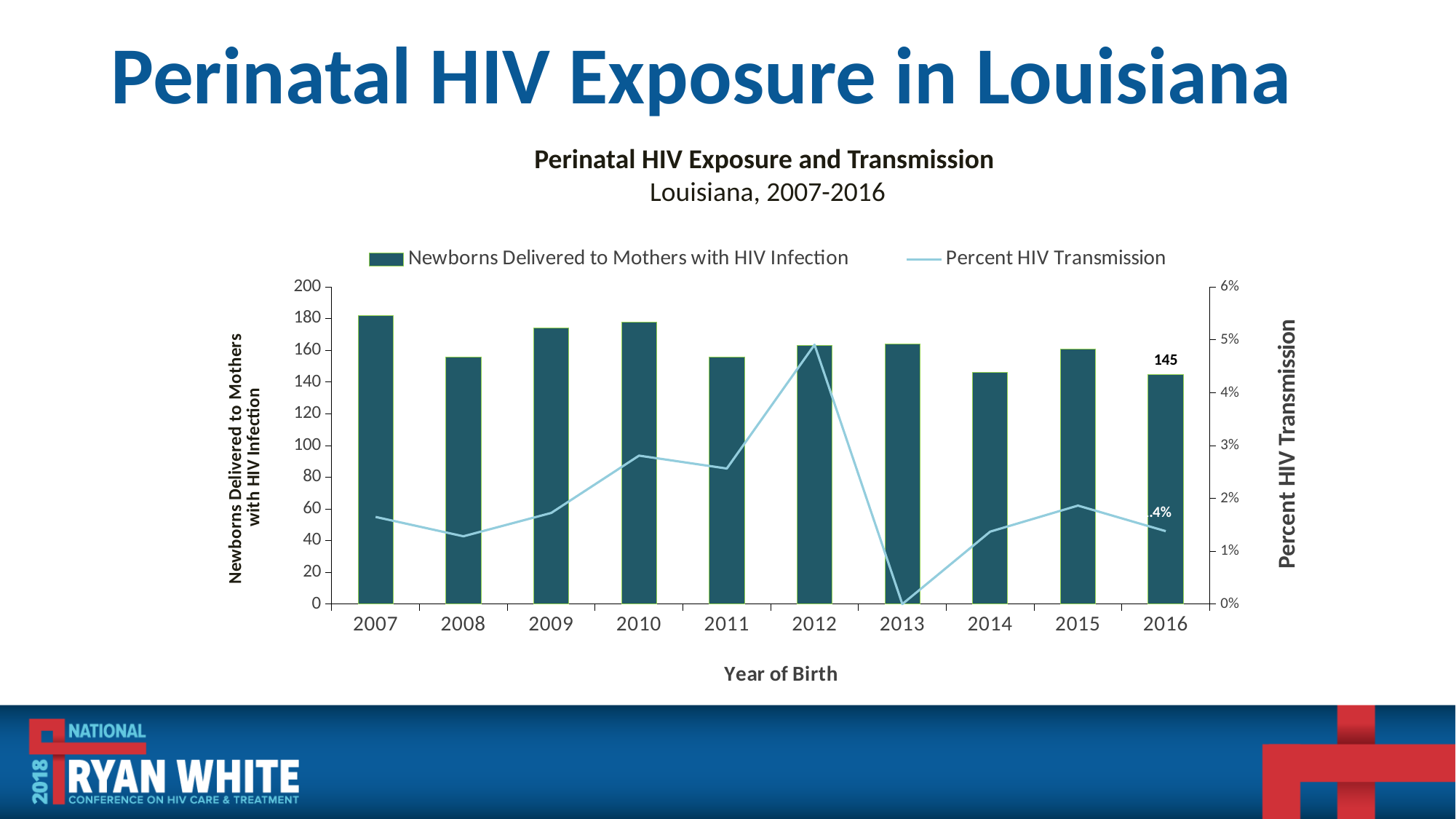
How many series does the legend list? 2 In which year of birth is the percent HIV transmission lowest? 2013 What kind of chart is shown on the slide? A combination bar and line chart Is the percent HIV transmission in 2012 greater or less than 4%? greater What is the percent HIV transmission in 2013? 0% Which year had more newborns delivered to mothers with HIV infection, 2007 or 2008? 2007 Is the number of newborns delivered to mothers with HIV infection in 2014 greater or less than 160? less Is the number of newborns delivered to mothers with HIV infection in 2007 greater or less than 160? greater What is the number of newborns delivered to mothers with HIV infection in 2016? 145 How many years of birth are shown on the x axis? 10 In which year of birth is the percent HIV transmission highest? 2012